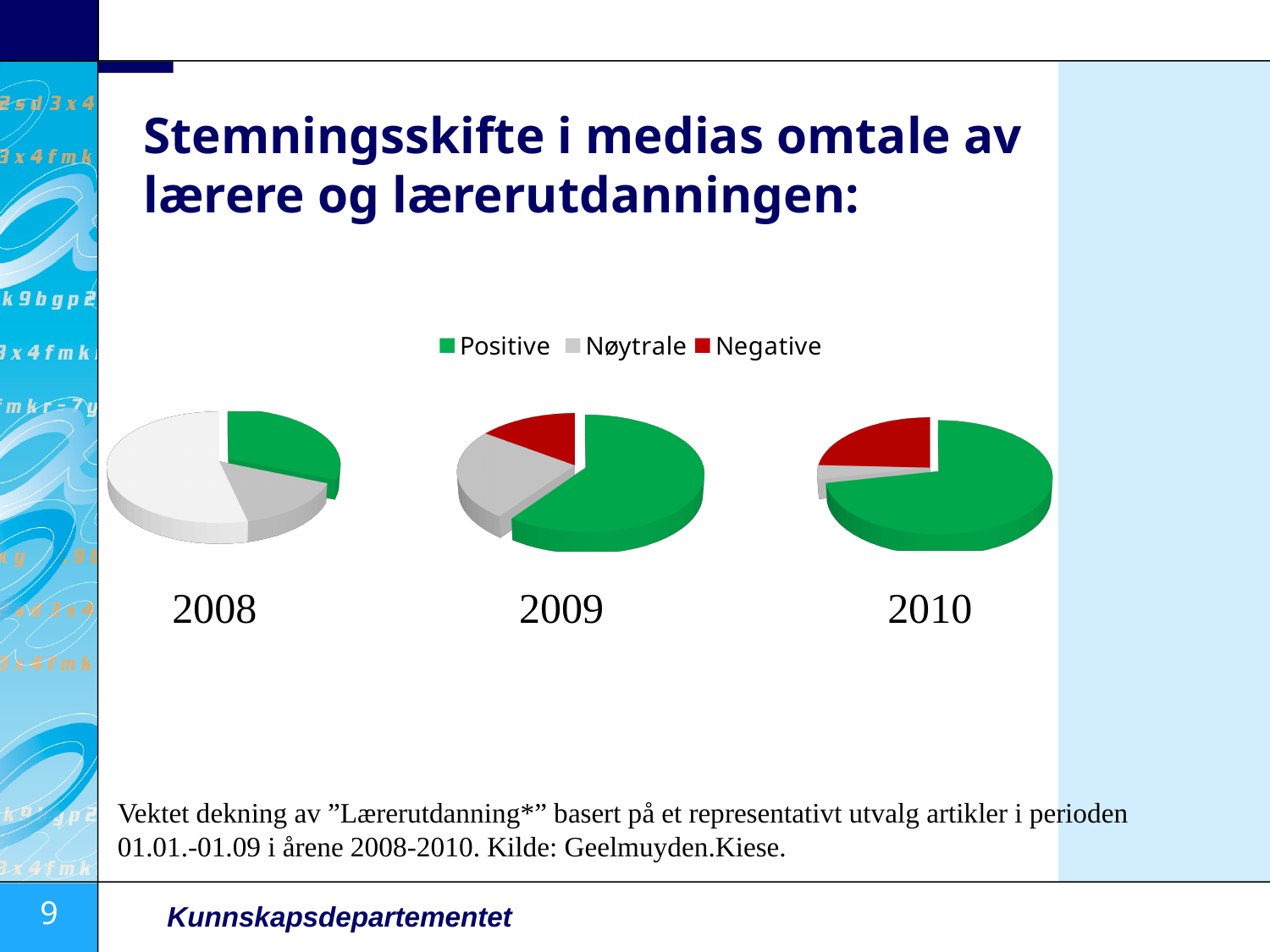
Which colour represents Positive in the legend? Green In the 2010 pie chart, which category has the largest share? Positive In the 2009 pie chart, which category has the smallest share? Negative In the 2009 pie chart, which category has the largest share? Positive In the 2010 pie chart, which category has the smallest share? Nøytrale In the 2008 pie chart, which is larger: the green Positive slice or the grey Nøytrale slice? Positive Does the Positive share rise or fall from the 2008 pie chart to the 2010 pie chart? Rise What kind of chart is used to show the media coverage for each year? Pie chart How many pie charts are shown on the slide? 3 In the 2009 pie chart, which is larger: Positive or Nøytrale? Positive In the 2010 pie chart, which is larger: Negative or Nøytrale? Negative How many series does the legend list? 3